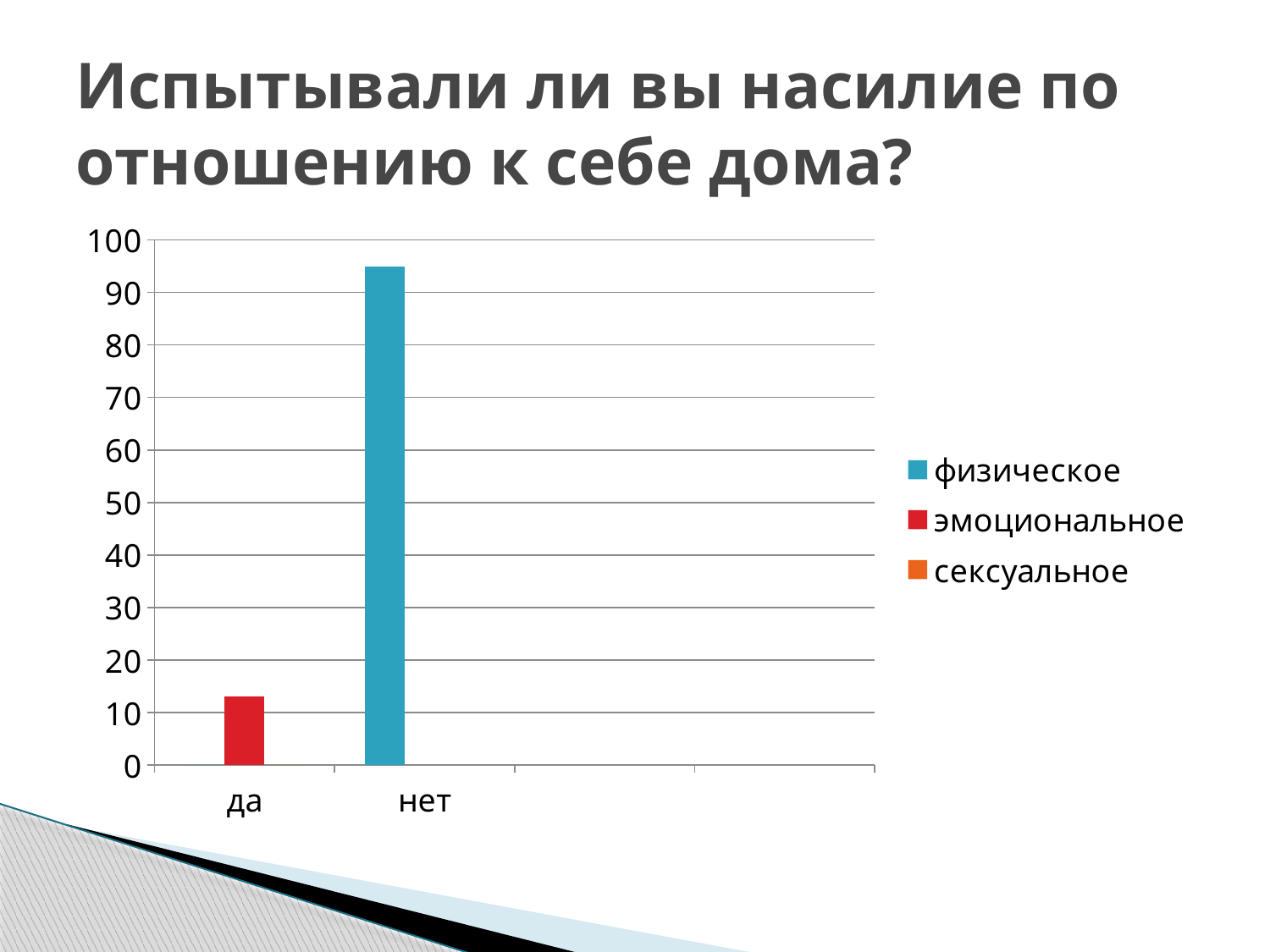
Is the bar for нет taller or shorter than the bar for да? taller What kind of chart is shown on the slide? bar chart Is the value of the bar for нет greater or less than 80? greater Which category has the tallest bar, да or нет? нет Is the value of the bar for да greater or less than 20? less How many series does the legend list? 3 Is the value of the bar for нет greater or less than 90? greater What is the highest value shown on the vertical axis? 100 How many category labels are shown on the x axis? 2 Which legend entry is shown in red? эмоциональное